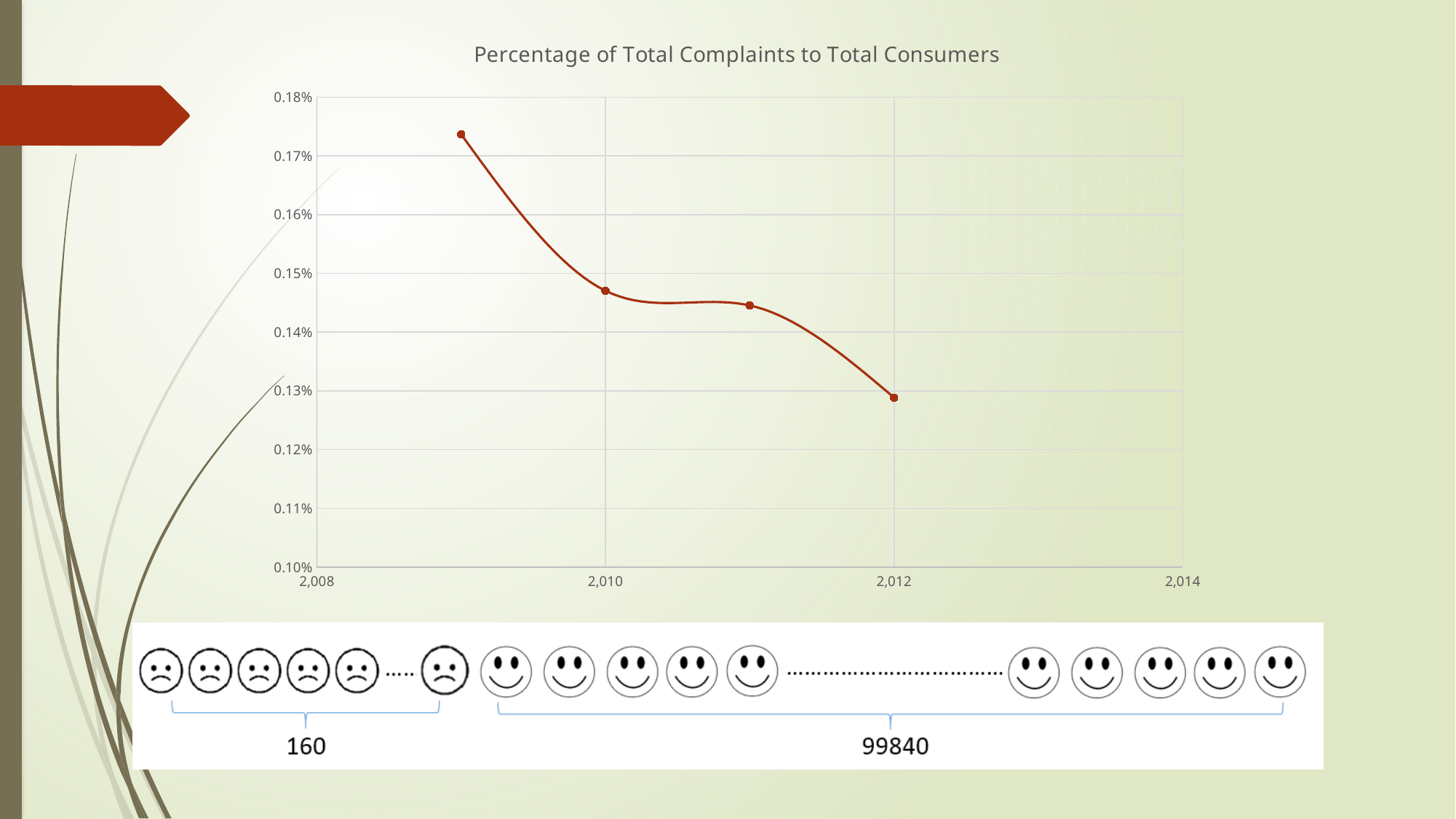
Is the value at 2,012 greater or less than 0.14%? less What is the title of the chart? Percentage of Total Complaints to Total Consumers Which plotted point has the lowest value? the last point, at 2,012 Which is larger, the value at 2,010 or the value at 2,012? 2,010 Is the value at 2,010 greater or less than 0.15%? less What kind of chart is shown on the slide? line chart How many data points are plotted on the line? 4 Is the value at 2,010 greater or less than 0.14%? greater Do the values rise or fall as the years increase along the x axis? fall What is the lowest value shown on the y axis? 0.10% Which plotted point has the highest value? the first (leftmost) point